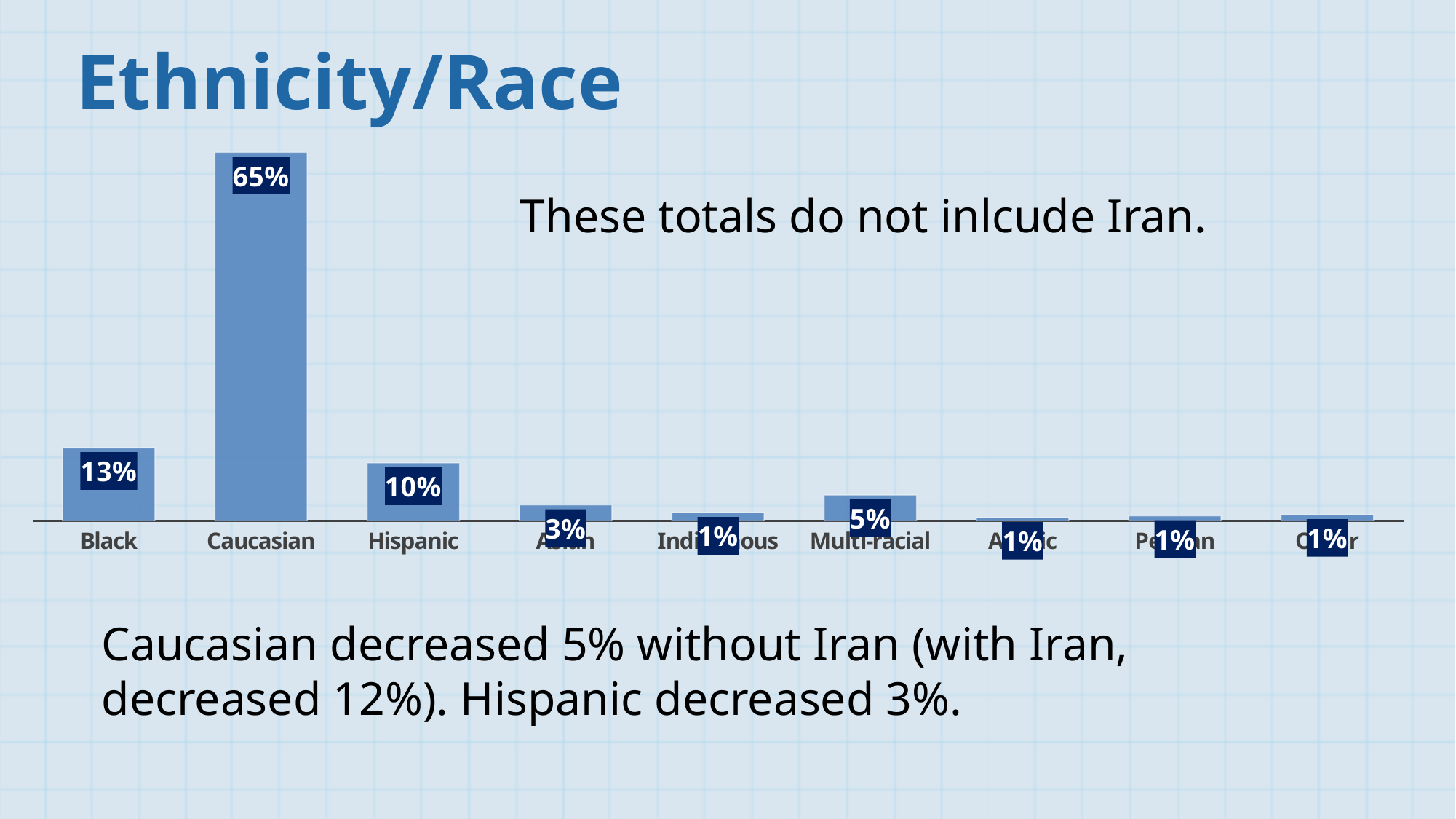
What is the title of the slide containing the chart? Ethnicity/Race What is the difference between the values for Black and Hispanic? 3% What is the value for Caucasian? 65% Which is larger, the value for Hispanic or the value for Multi-racial? Hispanic What kind of chart is shown on the slide? Bar chart How many categories are shown in the chart? 9 Which is larger, the value for Black or the value for Hispanic? Black What is the value for Hispanic? 10% Which category has the highest value? Caucasian What is the difference between the values for Caucasian and Black? 52% What is the value for Black? 13% What is the value for Multi-racial? 5%